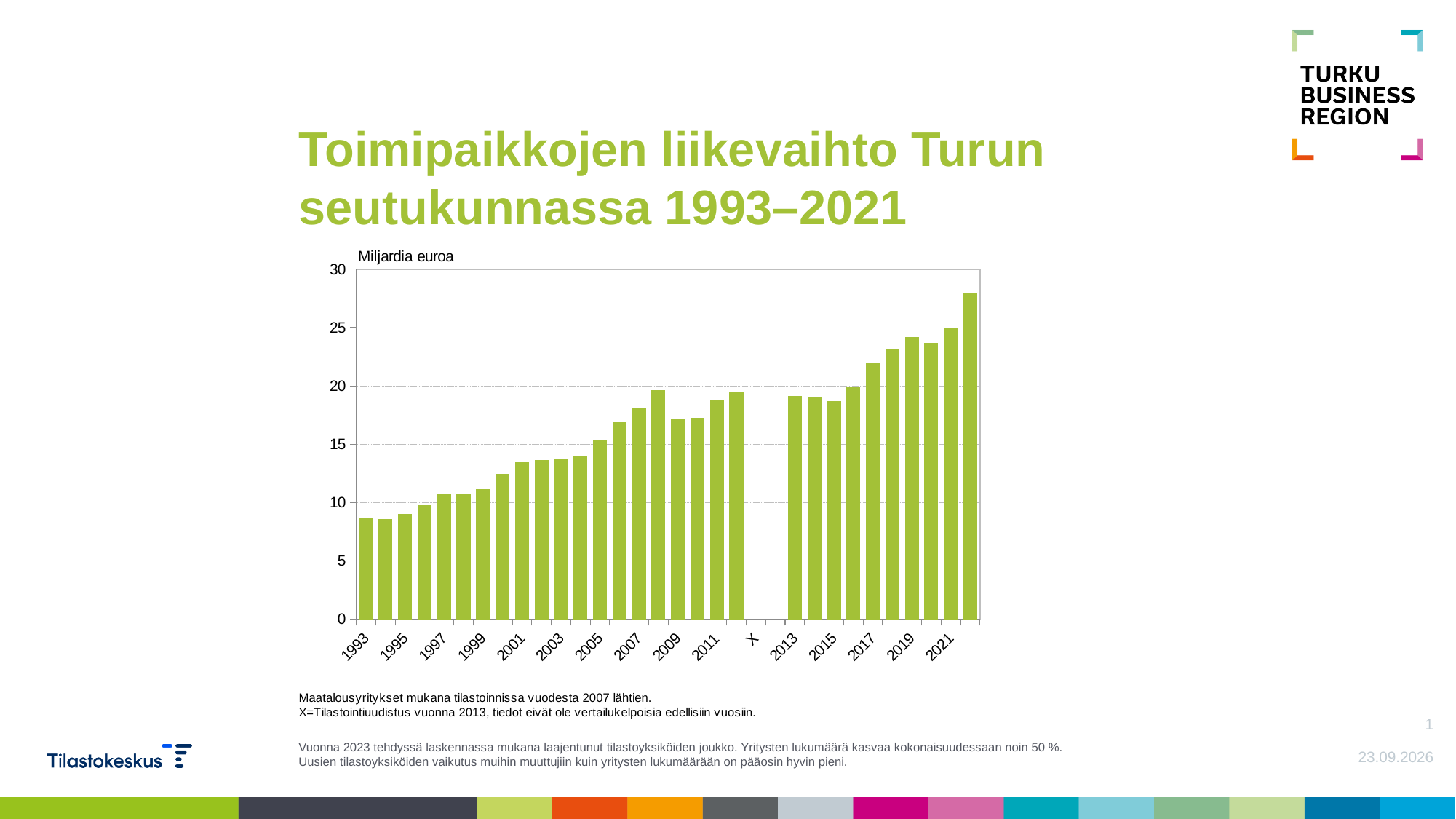
Is the value for 2017 greater or less than 20? greater What is the title of the chart on the slide? Toimipaikkojen liikevaihto Turun seutukunnassa 1993–2021 Is the value for 1993 greater or less than 10? less Is the value for 1999 greater or less than 10? greater Do the values generally rise or fall from 1993 to the end of the chart? rise What unit label is shown above the vertical axis of the chart? Miljardia euroa What kind of chart is shown on the slide? bar chart Which is larger, the value for 2007 or the value for 1993? 2007